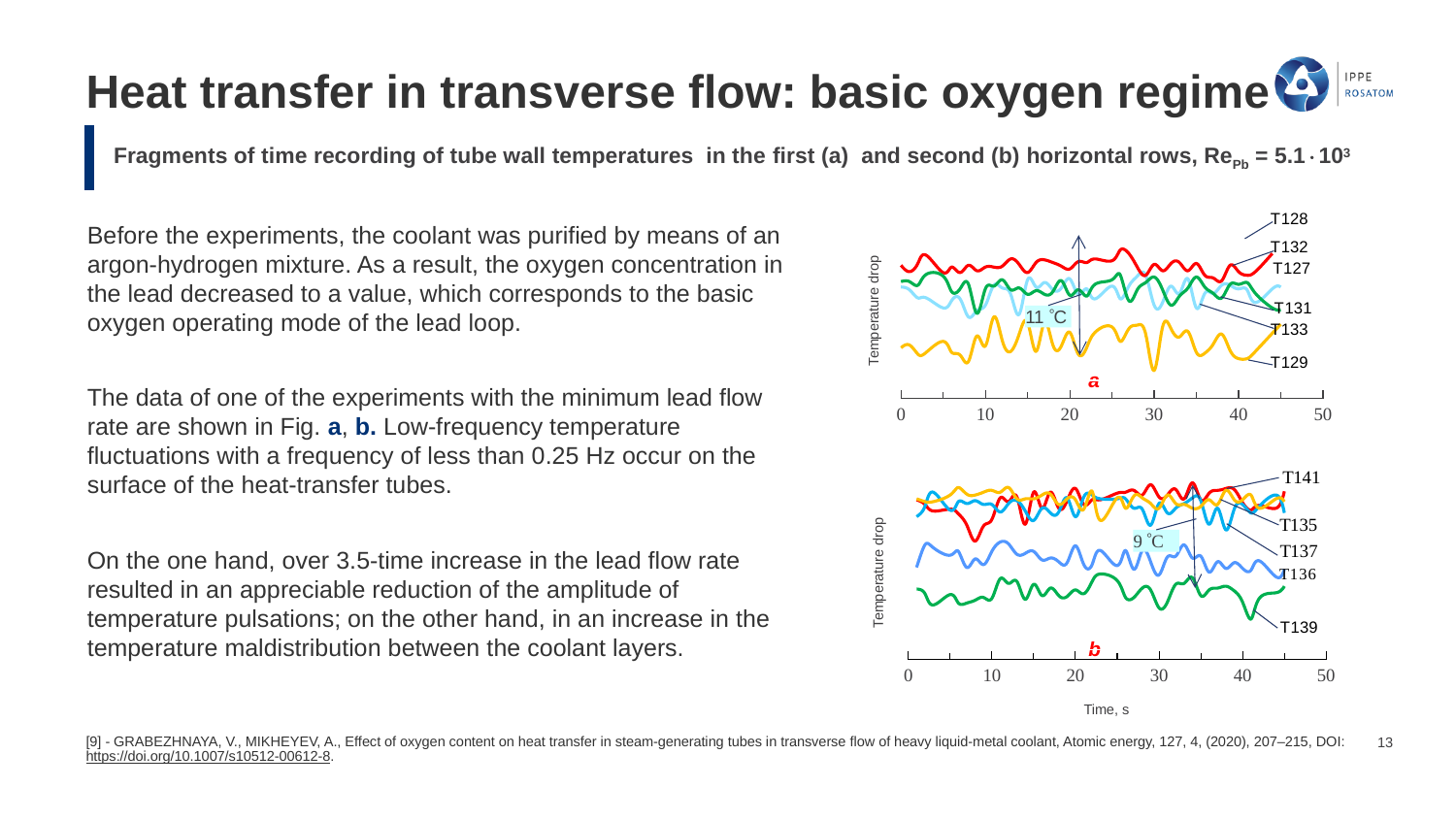
In Fig. b, which labelled trace lies lowest on the temperature drop axis? T139 What temperature difference is annotated between the traces in Fig. b? 9 °C What temperature difference is annotated between the traces in Fig. a? 11 °C In Fig. a, which labelled trace lies highest on the temperature drop axis? T128 In Fig. b, how many tube wall temperature traces are labelled? 5 In Fig. a, which labelled trace lies lowest on the temperature drop axis? T129 In Fig. a, which trace has the higher temperature drop, T128 or T129? T128 What is the maximum tick value on the time axis of Fig. b? 50 What is the label of the horizontal axis shared by Fig. a and Fig. b? Time, s In Fig. a, how many tube wall temperature traces are labelled? 6 What kind of chart is shown in Fig. a? line chart In Fig. b, which trace has the higher temperature drop, T141 or T139? T141